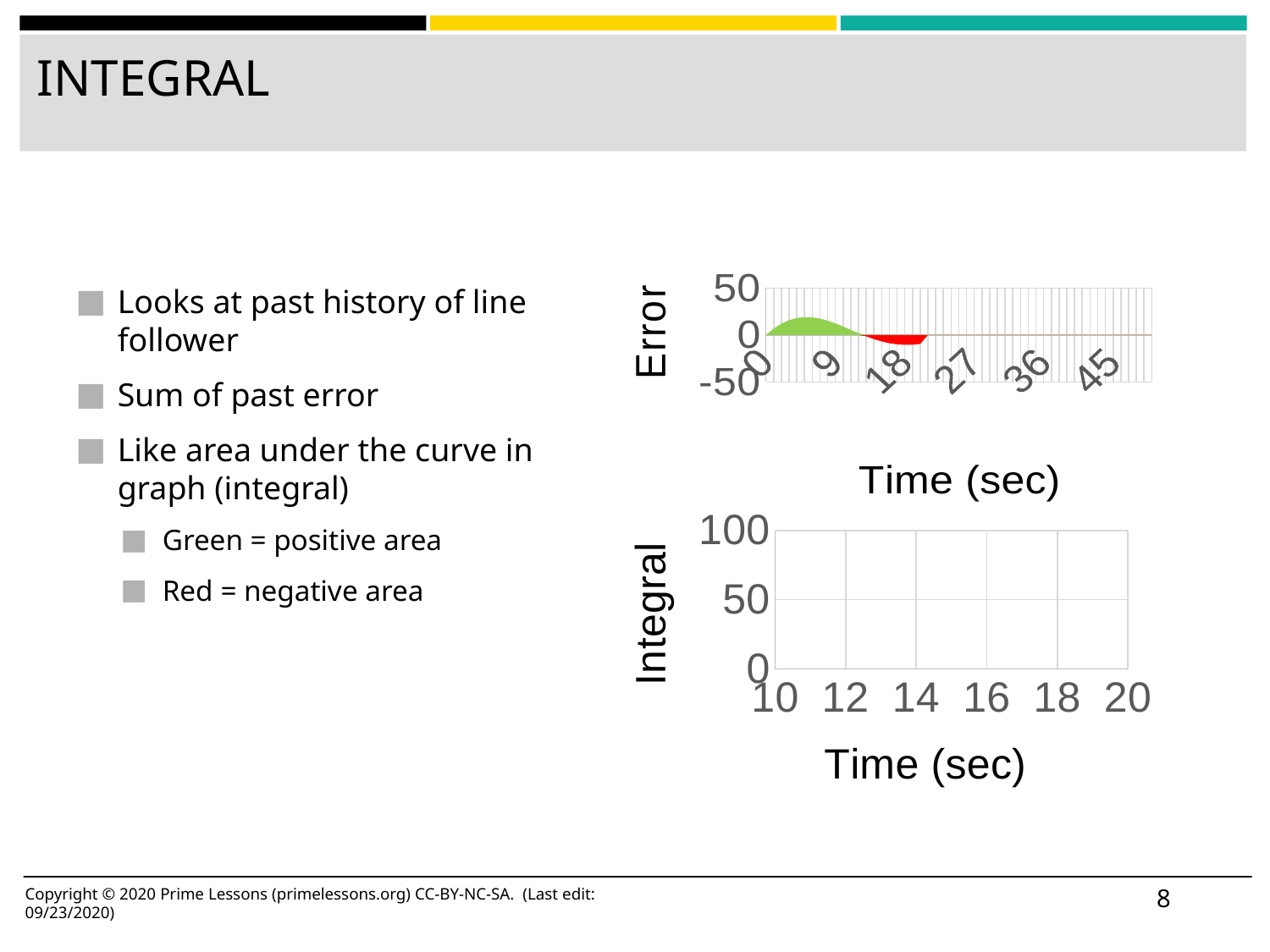
What kind of chart is the top chart (Error vs Time)? area chart What is the y-axis label of the bottom chart? Integral In the top chart (Error vs Time), is the error at time 9 greater or less than 0? greater In the top chart (Error vs Time), does the error rise or fall between time 9 and time 18? fall In the top chart (Error vs Time), which is larger, the error at time 9 or the error at time 18? time 9 How many tick labels are shown on the x axis of the top chart (Error vs Time)? 6 What is the y-axis label of the top chart? Error In the top chart (Error vs Time), is the error at time 18 greater or less than 0? less